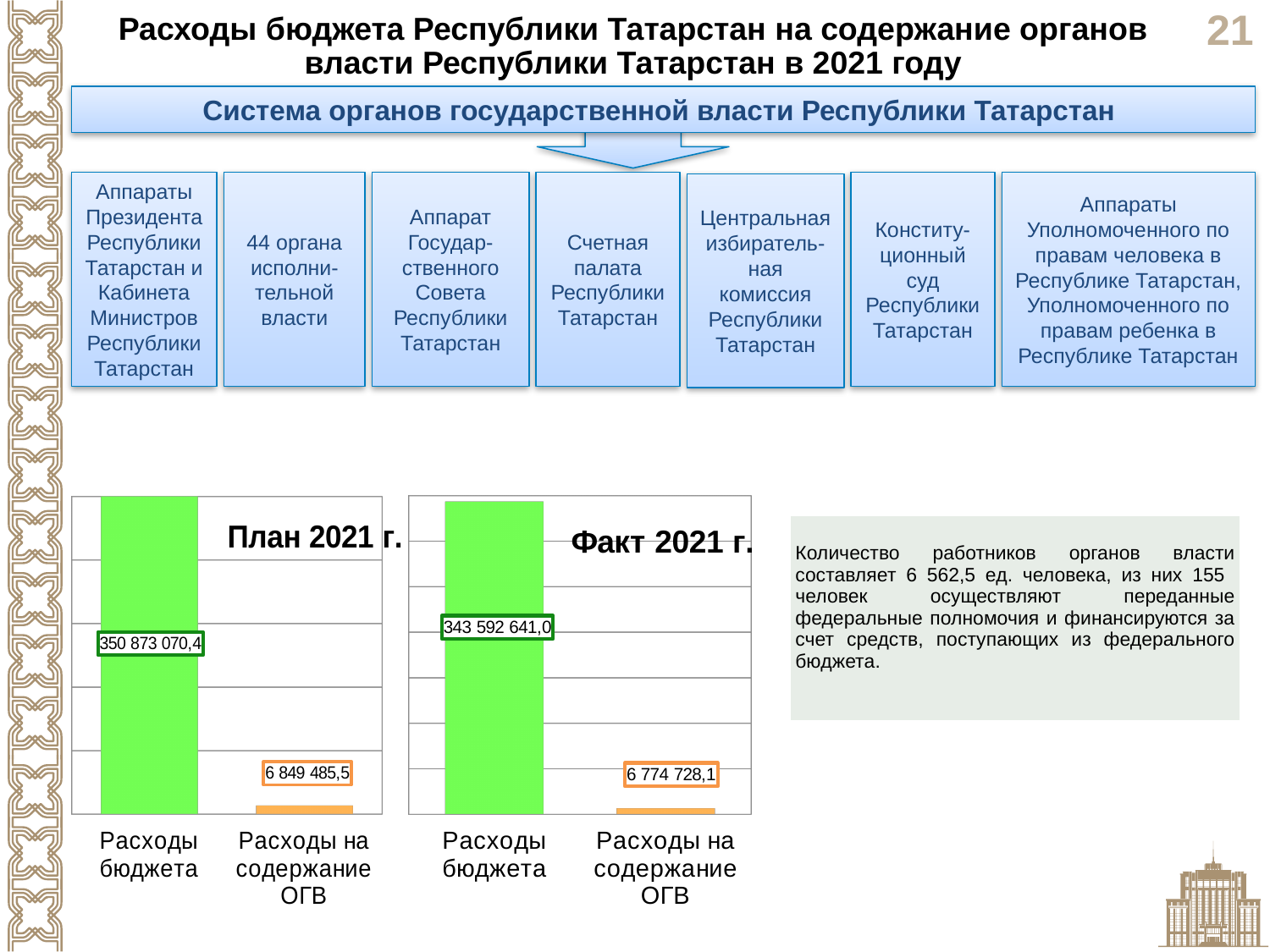
On the "План 2021 г." chart, which category has the highest value? Расходы бюджета On the "Факт 2021 г." chart, what is the difference between "Расходы бюджета" and "Расходы на содержание ОГВ"? 336 817 912,9 On the "План 2021 г." chart, what is the value for "Расходы бюджета"? 350 873 070,4 How many categories are shown on the "Факт 2021 г." chart? 2 What type of chart is the "План 2021 г." chart? Bar chart On the "Факт 2021 г." chart, which category has the lowest value? Расходы на содержание ОГВ On the "Факт 2021 г." chart, what colour is the "Расходы бюджета" bar? Green On the "Факт 2021 г." chart, what is the value for "Расходы на содержание ОГВ"? 6 774 728,1 On the "План 2021 г." chart, what is the difference between "Расходы бюджета" and "Расходы на содержание ОГВ"? 344 023 584,9 On the "Факт 2021 г." chart, what is the value for "Расходы бюджета"? 343 592 641,0 Which is larger: "Расходы бюджета" on the "План 2021 г." chart or "Расходы бюджета" on the "Факт 2021 г." chart? План 2021 г. On the "План 2021 г." chart, what is the value for "Расходы на содержание ОГВ"? 6 849 485,5